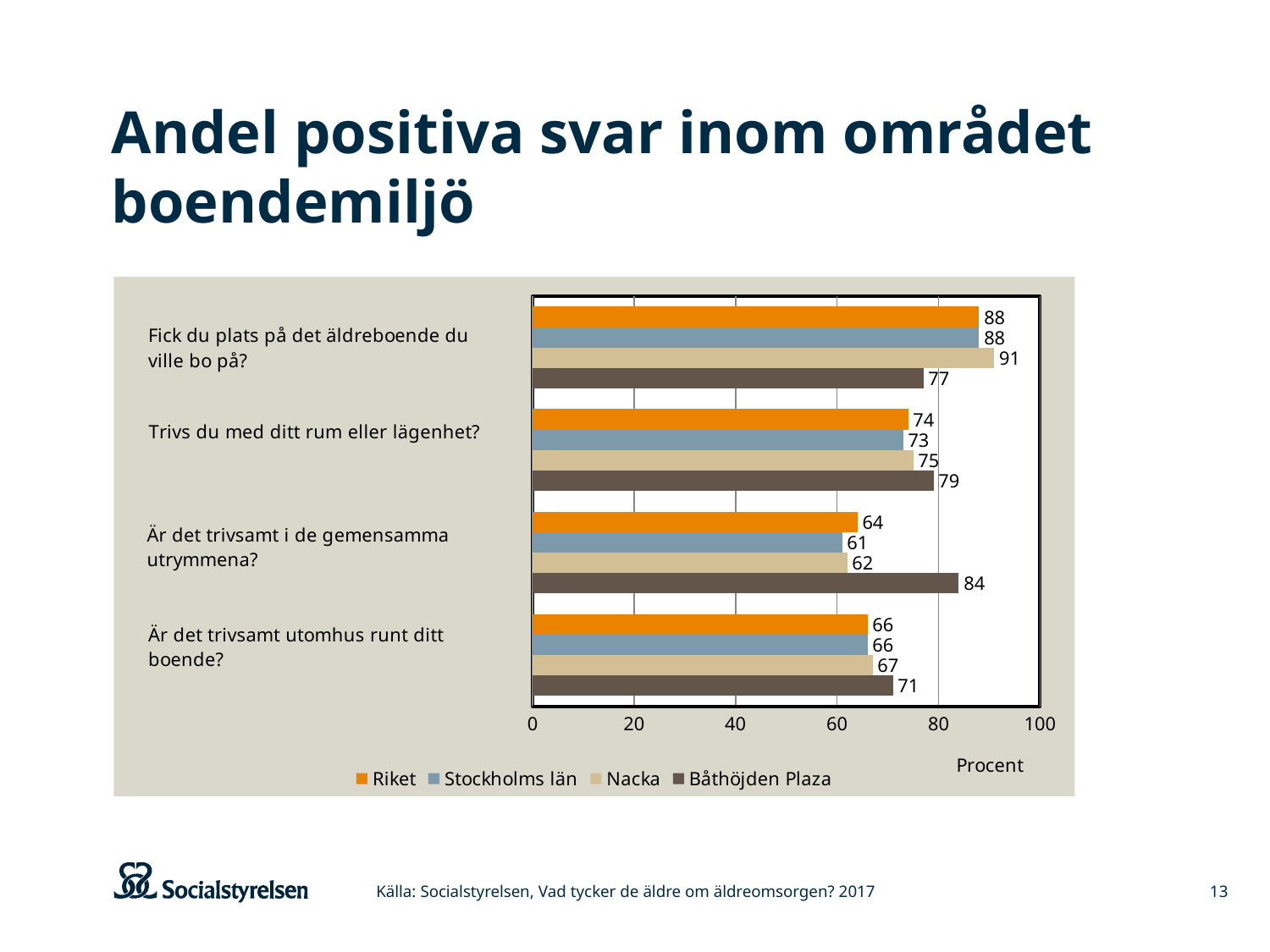
What is the value for Riket on "Är det trivsamt utomhus runt ditt boende?"? 66 Which series has the highest value on "Fick du plats på det äldreboende du ville bo på?"? Nacka Which is larger on "Trivs du med ditt rum eller lägenhet?": Riket or Båthöjden Plaza? Båthöjden Plaza What is the value for Nacka on "Fick du plats på det äldreboende du ville bo på?"? 91 What is the value for Båthöjden Plaza on "Är det trivsamt i de gemensamma utrymmena?"? 84 What kind of chart is shown on the slide? Bar chart How many questions (categories) are shown on the chart? 4 What is the difference between Båthöjden Plaza and Nacka on "Är det trivsamt i de gemensamma utrymmena?"? 22 What is the value for Stockholms län on "Trivs du med ditt rum eller lägenhet?"? 73 How many series does the legend list? 4 What is the label on the horizontal axis of the chart? Procent Which series has the lowest value on "Är det trivsamt i de gemensamma utrymmena?"? Stockholms län